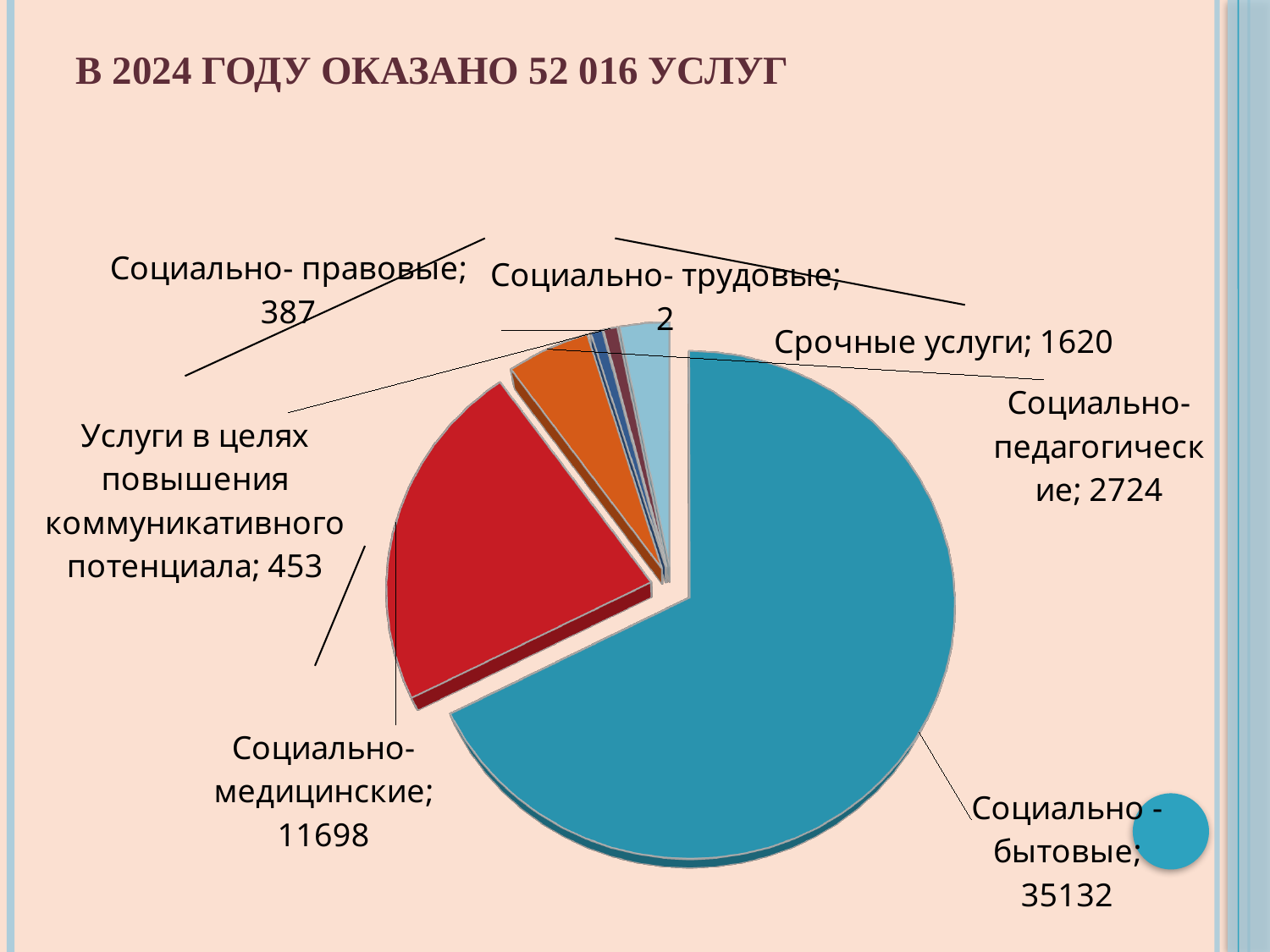
How many categories are shown in the pie chart? 7 What is the difference between Социально-бытовые and Социально-медицинские? 23434 What is the difference between Социально-педагогические and Срочные услуги? 1104 Which is larger: Социально-правовые or Услуги в целях повышения коммуникативного потенциала? Услуги в целях повышения коммуникативного потенциала Which category has the smallest value? Социально-трудовые What total number of services does the slide title state were provided in 2024? 52 016 What is the value for Услуги в целях повышения коммуникативного потенциала? 453 How many services are shown for the category Социально-бытовые? 35132 Which category has the largest slice of the pie? Социально-бытовые What type of chart is shown on the slide? pie chart What is the value for Социально-медицинские? 11698 What is the value for Срочные услуги? 1620